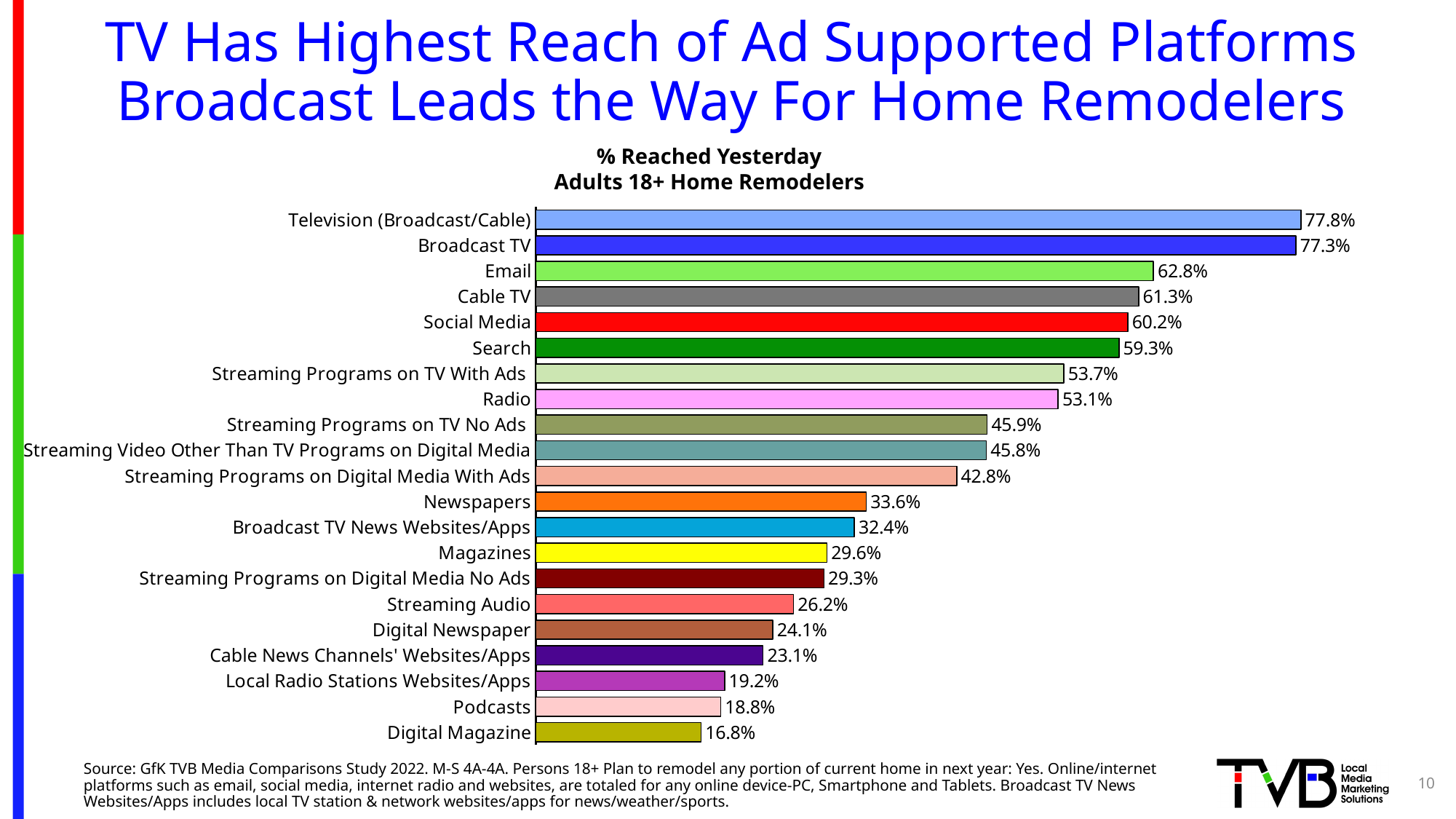
What is the % reached yesterday for Broadcast TV? 77.3% What is the difference in percentage points between Email and Cable TV? 1.5 What is the % reached yesterday for Social Media? 60.2% Which platform has the highest % reached yesterday? Television (Broadcast/Cable) What is the % reached yesterday for Streaming Programs on Digital Media With Ads? 42.8% What kind of chart is shown on the slide? Bar chart What is the title of the chart? % Reached Yesterday Adults 18+ Home Remodelers What is the % reached yesterday for Podcasts? 18.8% Which has a higher % reached yesterday, Radio or Newspapers? Radio What is the difference in percentage points between Television (Broadcast/Cable) and Digital Magazine? 61.0 Which platform has the lowest % reached yesterday? Digital Magazine How many platforms are shown in the chart? 21